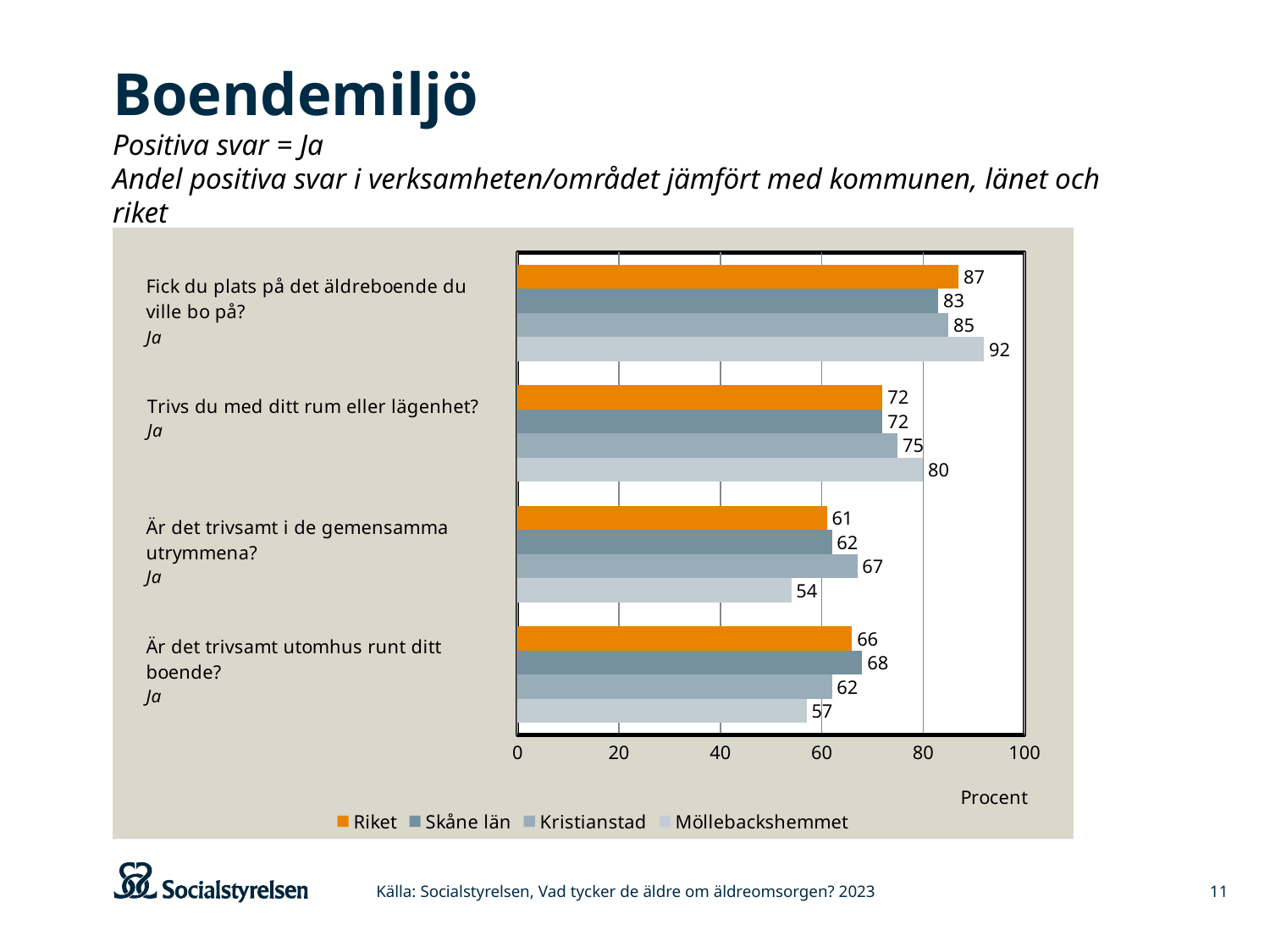
What is the value for Riket for 'Trivs du med ditt rum eller lägenhet?' 72 What is the value for Skåne län for 'Är det trivsamt utomhus runt ditt boende?' 68 What unit is shown on the x axis of the chart? Procent How many survey questions (categories) are shown on the chart? 4 How many series does the legend list? 4 What is the value for Kristianstad for 'Är det trivsamt i de gemensamma utrymmena?' 67 What is the value for Möllebackshemmet for 'Fick du plats på det äldreboende du ville bo på?' 92 What type of chart is shown on the slide? Bar chart What is the difference between Möllebackshemmet and Riket for 'Trivs du med ditt rum eller lägenhet?' 8 Which series has the lowest value for 'Är det trivsamt utomhus runt ditt boende?' Möllebackshemmet For 'Är det trivsamt i de gemensamma utrymmena?', which is larger: Kristianstad or Möllebackshemmet? Kristianstad Which series has the highest value for 'Fick du plats på det äldreboende du ville bo på?' Möllebackshemmet